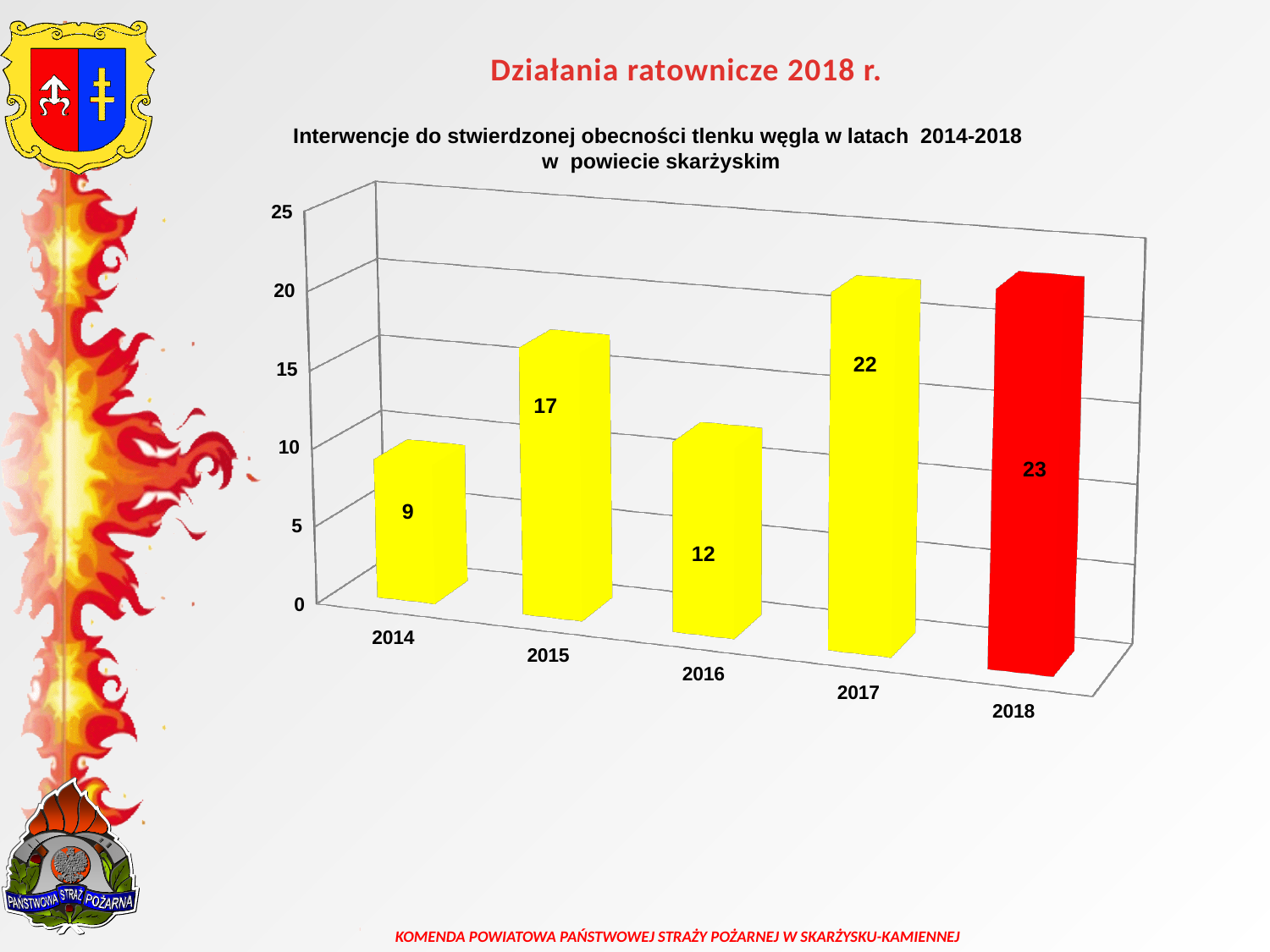
What is the value for 2016? 12 How many years are shown on the chart? 5 Which year has the lowest value? 2014 Which is larger, the value for 2015 or the value for 2016? 2015 Which year has the highest value? 2018 What is the difference between the values for 2017 and 2015? 5 Is the value for 2017 greater or less than 20? greater What kind of chart is shown? bar chart What is the value for 2014? 9 What is the title of the chart? Interwencje do stwierdzonej obecności tlenku węgla w latach 2014-2018 w powiecie skarżyskim Which bar is coloured red? 2018 What is the value for 2018? 23